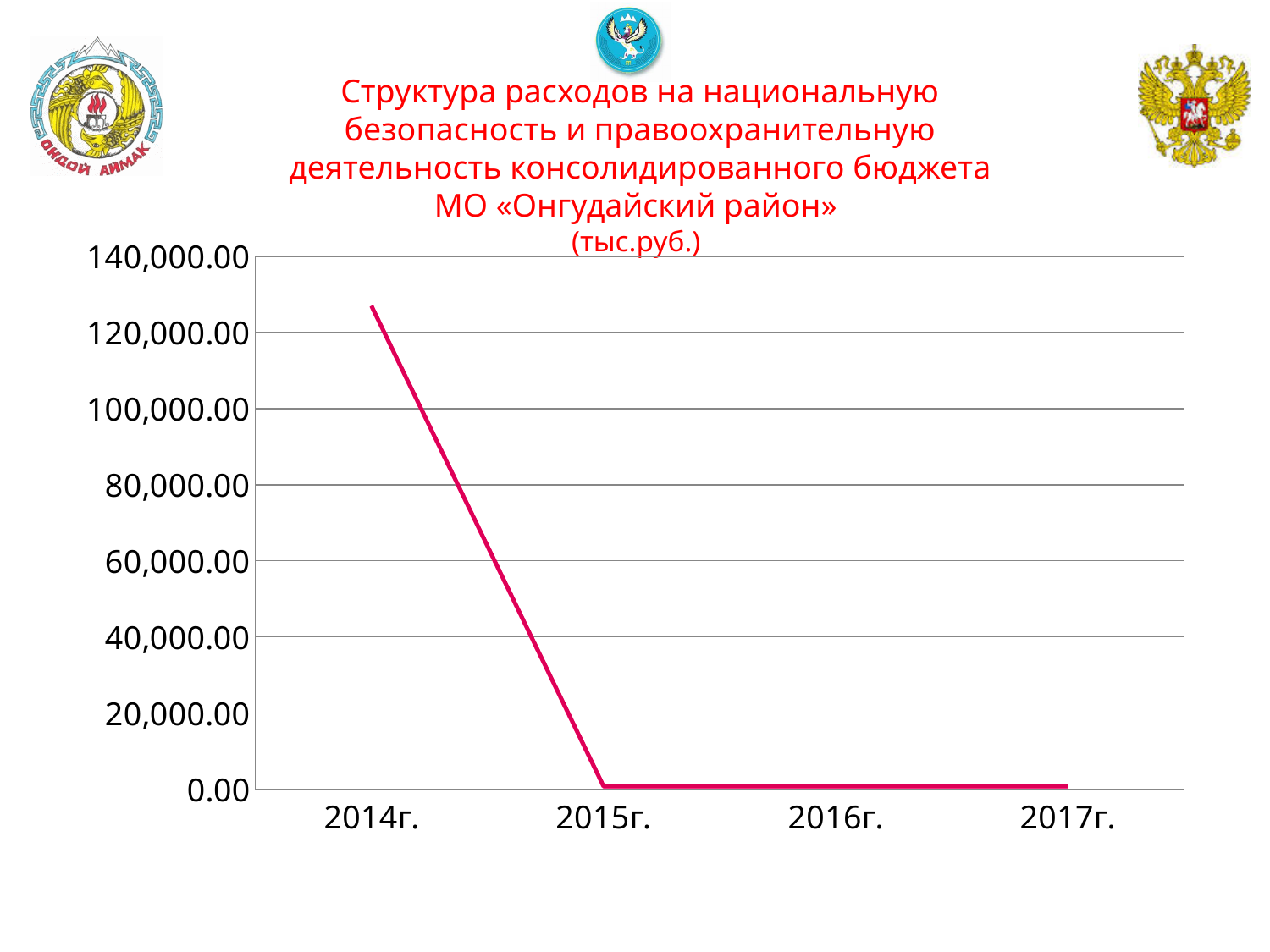
Is the value for 2015г. greater or less than 20,000.00? less Do the values rise or fall from 2014г. to 2015г.? fall Is the value for 2014г. greater or less than 120,000.00? greater Is the value for 2017г. greater or less than 20,000.00? less What unit is given in parentheses under the chart title? тыс.руб. Which year has the highest value? 2014г. What is the first year shown on the x axis? 2014г. Which is larger, the value for 2014г. or the value for 2016г.? 2014г. What kind of chart is shown on the slide? line chart How many years are plotted along the x axis? 4